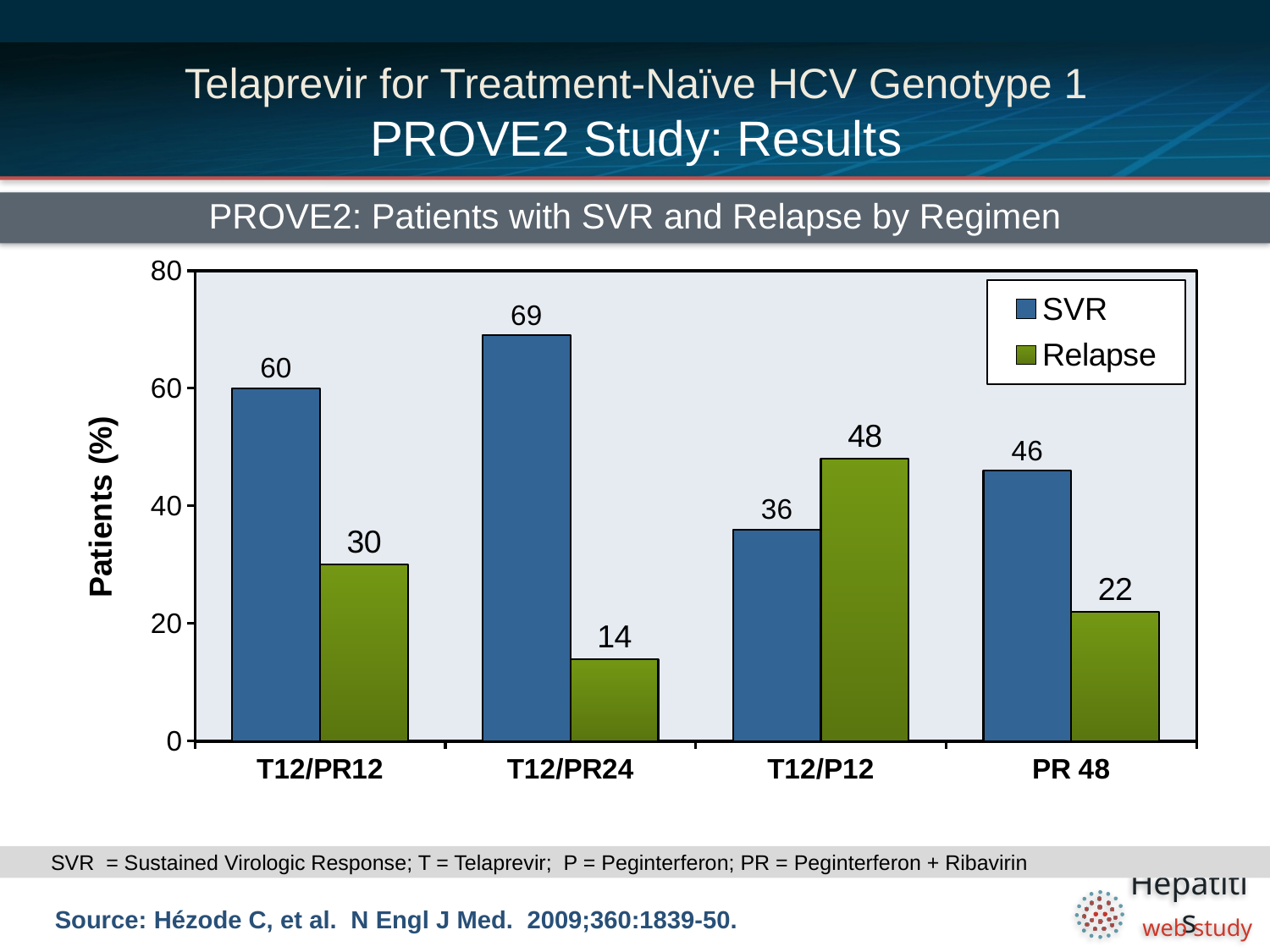
What is the SVR value for PR 48? 46 What is the SVR value for T12/PR24? 69 What is the label of the y axis? Patients (%) What is the difference between the SVR and Relapse values for T12/PR12? 30 Which regimen has the highest SVR value? T12/PR24 How many regimens are shown on the x axis? 4 What kind of chart is shown? bar chart How many series does the legend list? 2 Which regimen has the lowest Relapse value? T12/PR24 Which is larger for T12/P12, the SVR value or the Relapse value? Relapse Is the Relapse value for PR 48 greater or less than 40? less What is the Relapse value for T12/P12? 48